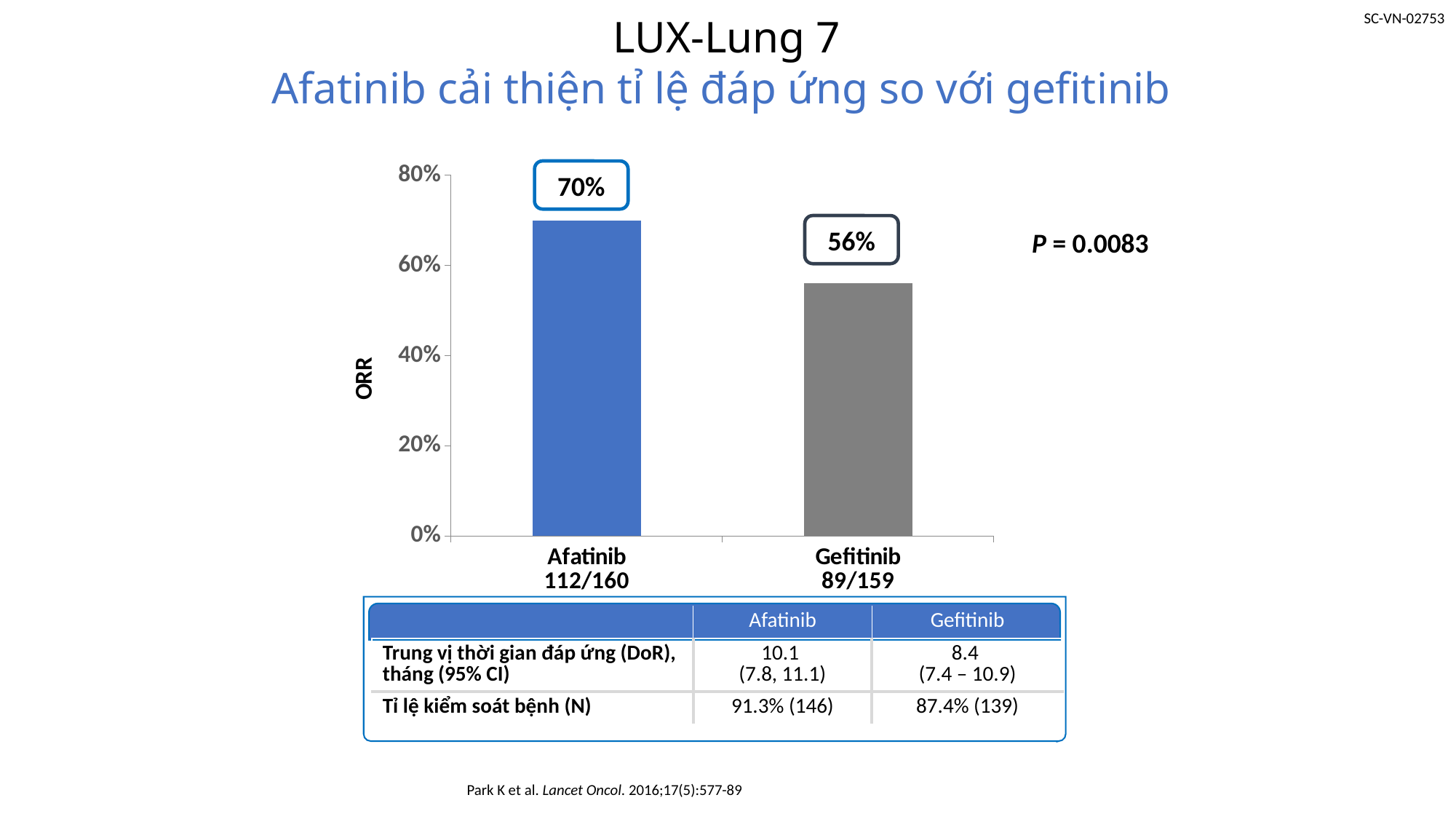
What is the ORR value for Afatinib? 70% What is the label of the y axis? ORR Which treatment has the lower ORR? Gefitinib How many treatment categories are shown in the chart? 2 Is the ORR for Afatinib larger or smaller than the ORR for Gefitinib? larger What is the ORR value for Gefitinib? 56% Which treatment has the higher ORR? Afatinib What kind of chart is shown on the slide? bar chart What is the difference in ORR between Afatinib and Gefitinib? 14% Is the value for Gefitinib greater or less than 60%? less What P value is shown next to the chart? P = 0.0083 Is the value for Afatinib greater or less than 60%? greater